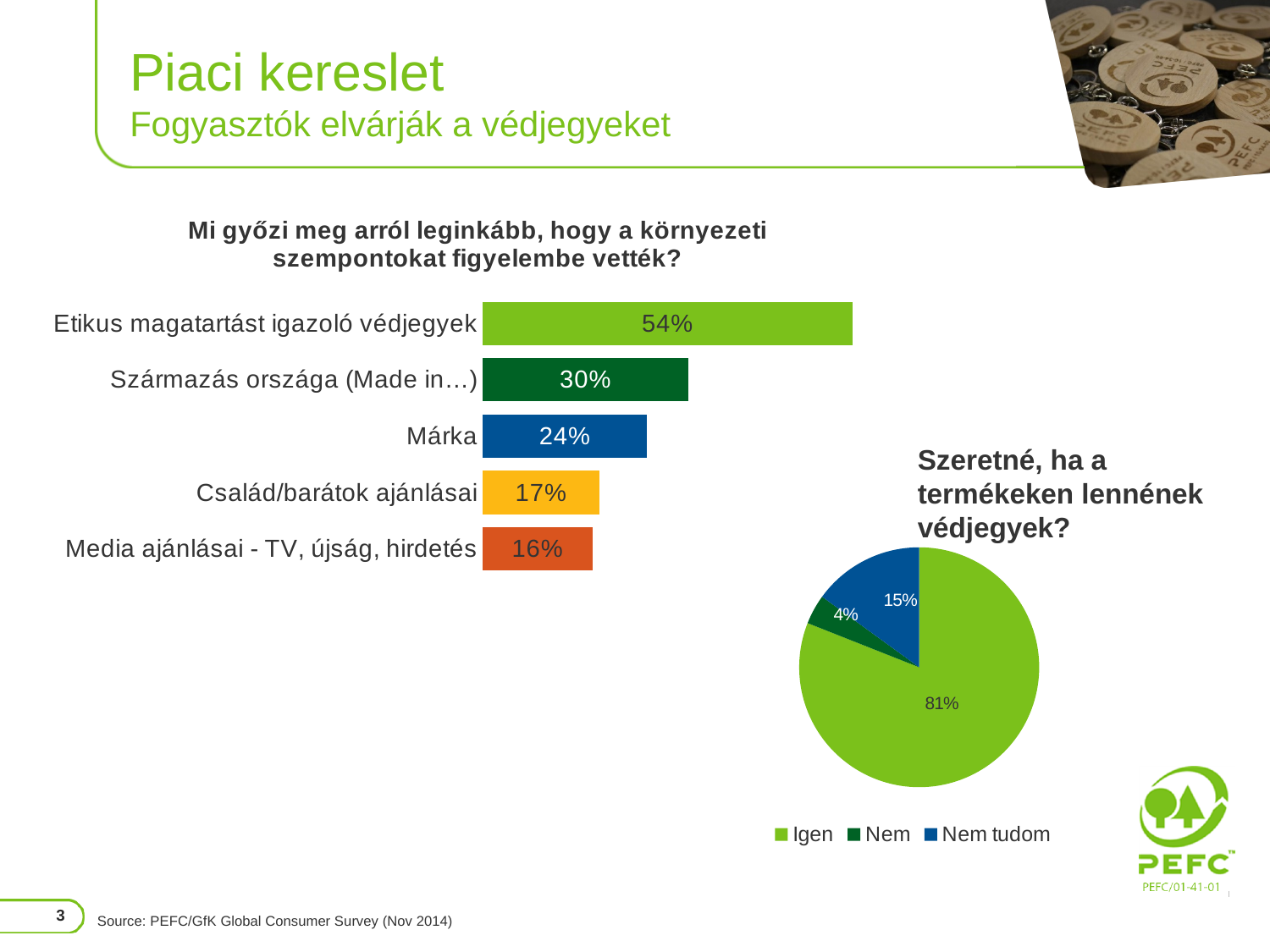
In the bar chart on the left, which is larger: "Család/barátok ajánlásai" or "Márka"? Márka In the pie chart "Szeretné, ha a termékeken lennének védjegyek?", what share does "Nem tudom" have? 15% How many categories does the bar chart on the left show? 5 In the bar chart on the left, what is the difference between "Etikus magatartást igazoló védjegyek" and "Származás országa (Made in…)"? 24% How many entries does the legend of the pie chart list? 3 In the bar chart on the left, what is the value for "Márka"? 24% In the pie chart "Szeretné, ha a termékeken lennének védjegyek?", what share does "Igen" have? 81% In the pie chart "Szeretné, ha a termékeken lennének védjegyek?", which slice is the smallest? Nem What kind of chart is the chart on the left of the slide? bar chart In the bar chart on the left, which category has the highest value? Etikus magatartást igazoló védjegyek In the bar chart on the left, which category has the lowest value? Media ajánlásai - TV, újság, hirdetés In the bar chart on the left, what is the value for "Származás országa (Made in…)"? 30%